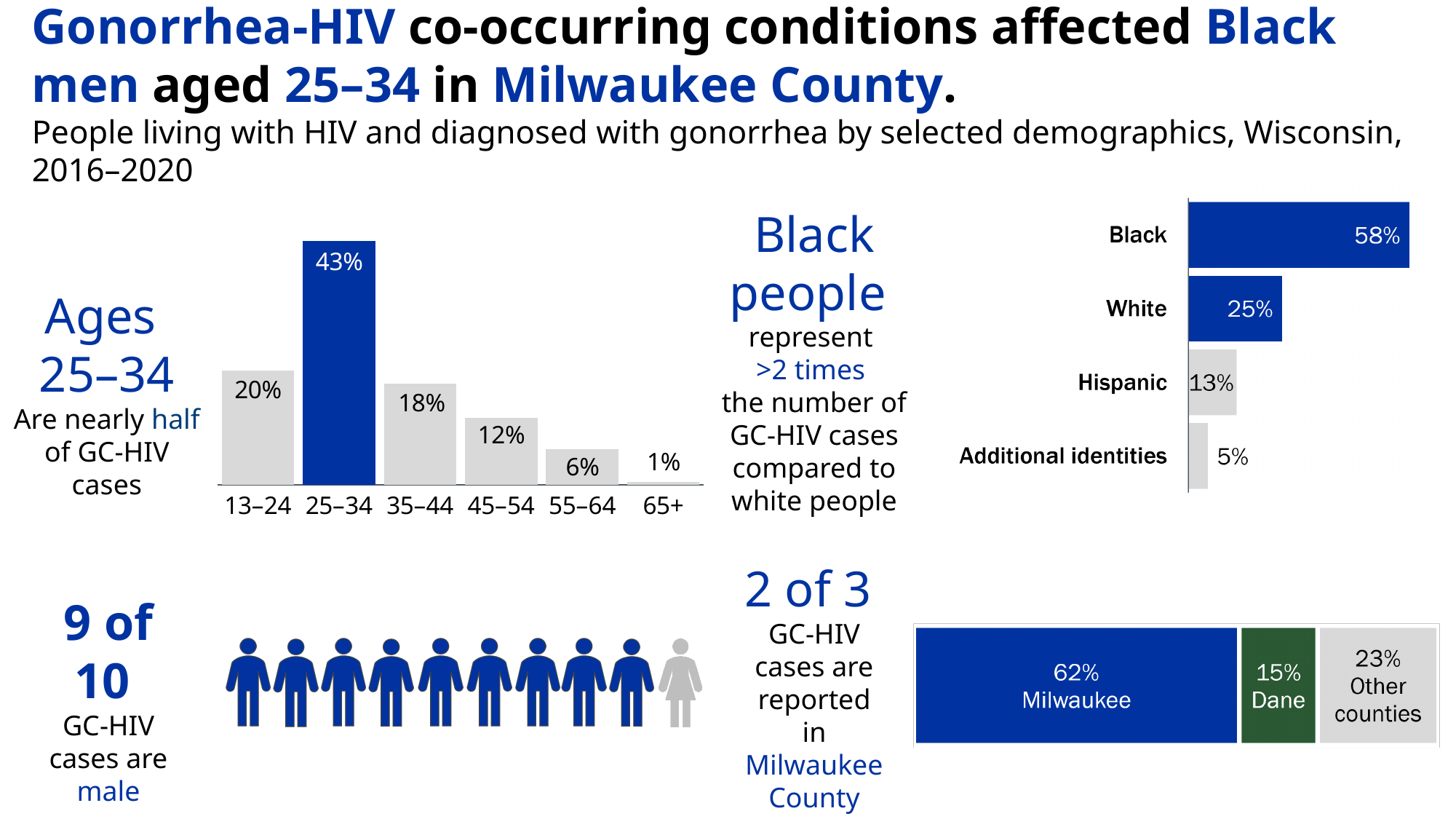
In the county bar at the bottom right, what is the total of the Milwaukee, Dane and Other counties segments? 100% In the age group bar chart at the top left, what is the difference between the 13–24 and 35–44 percentages? 2% In the race/ethnicity bar chart at the top right, what is the difference between the Black and White percentages? 33% In the age group bar chart at the top left, which age group has the lowest percentage? 65+ In the age group bar chart at the top left, how many age groups are shown? 6 In the race/ethnicity bar chart at the top right, what percentage is shown for Hispanic? 13% In the county bar at the bottom right, what percentage of GC-HIV cases are reported in Dane? 15% In the age group bar chart at the top left, do the values rise or fall from 25–34 to 65+? fall What kind of chart is the race/ethnicity chart at the top right? bar chart In the age group bar chart at the top left, what percentage of GC-HIV cases are in the 25–34 age group? 43% In the race/ethnicity bar chart at the top right, which category has the highest percentage? Black In the race/ethnicity bar chart at the top right, which is larger, White or Additional identities? White